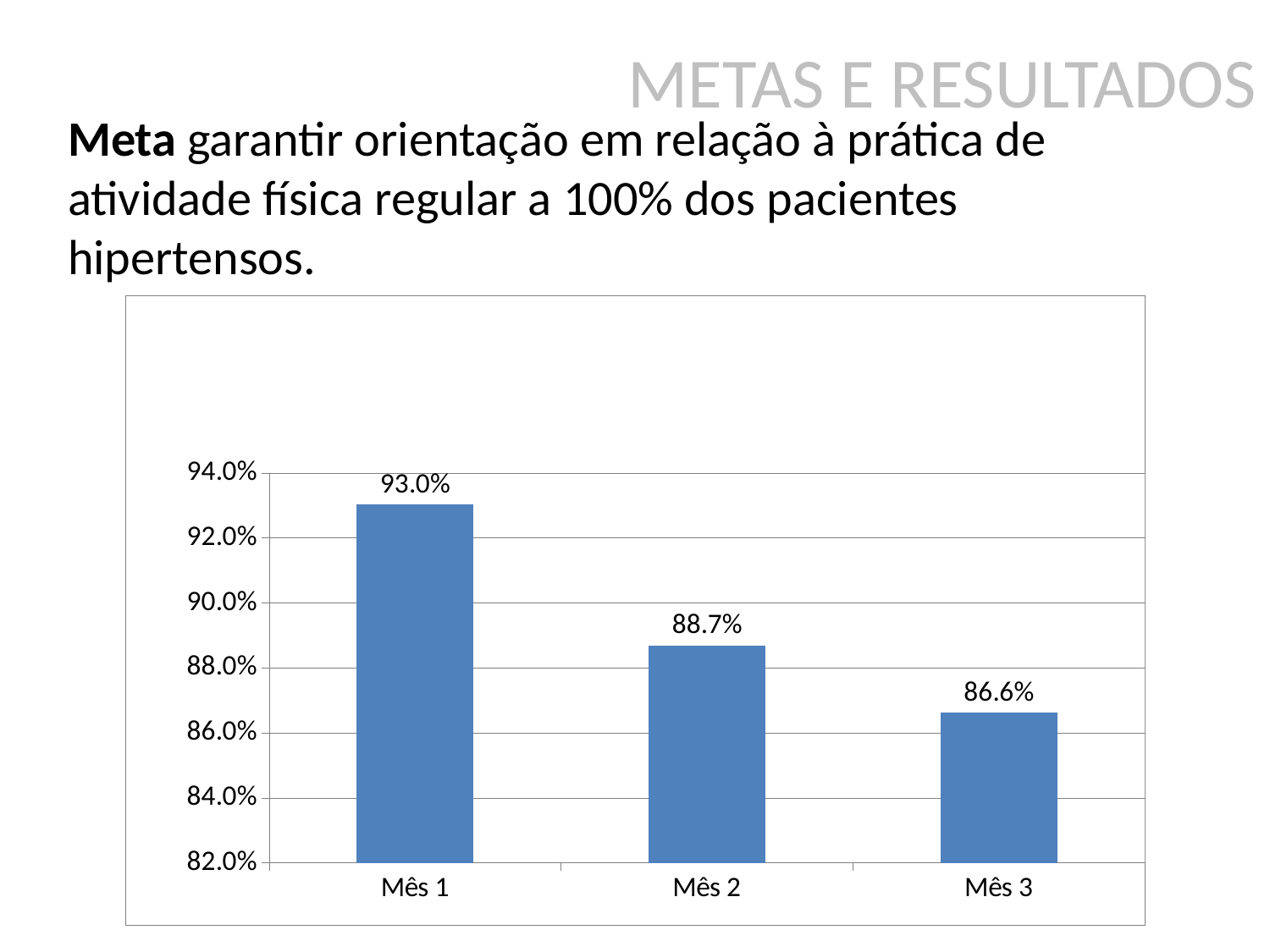
Which month has the highest value? Mês 1 Which is larger, the value for Mês 1 or the value for Mês 2? Mês 1 How many months are shown on the x axis? 3 Which month has the lowest value? Mês 3 Do the values rise or fall from Mês 1 to Mês 3? fall What is the value for Mês 1? 93.0% What kind of chart is shown on the slide? bar chart Is the value for Mês 2 greater or less than 90.0%? less What is the value for Mês 2? 88.7% What is the difference between the values for Mês 1 and Mês 3? 6.4% What is the value for Mês 3? 86.6% What is the difference between the values for Mês 2 and Mês 3? 2.1%